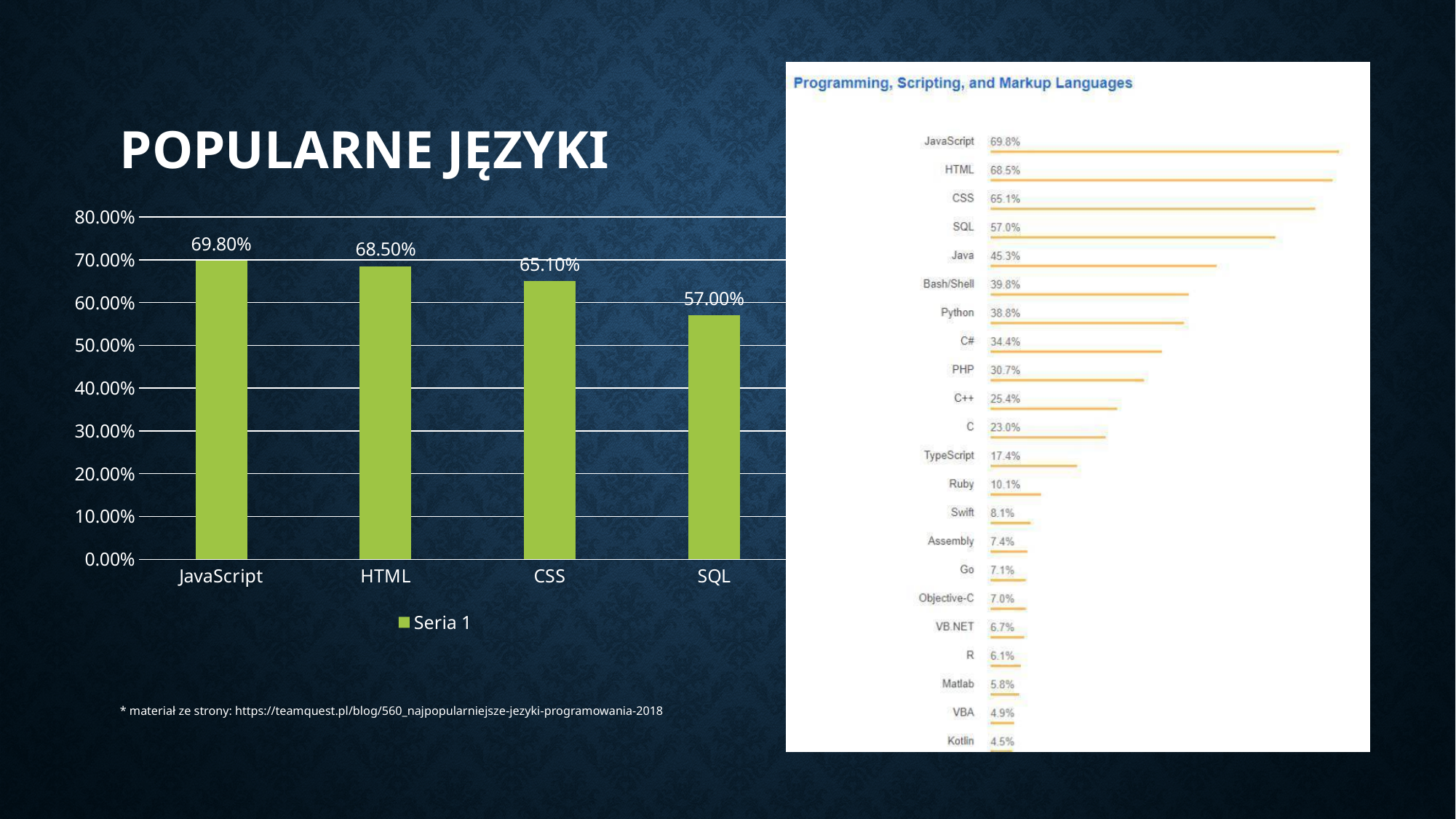
In the left bar chart, how many categories are shown on the x axis? 4 In the left bar chart, which category has the highest value? JavaScript In the chart titled 'Programming, Scripting, and Markup Languages', which is larger, the value for Java or the value for PHP? Java In the left bar chart, how many series does the legend list? 1 In the left bar chart, what is the difference between the values for JavaScript and SQL? 12.80% In the chart titled 'Programming, Scripting, and Markup Languages', which language has the lowest value? Kotlin In the left bar chart, which category has the lowest value? SQL In the left bar chart, what is the value for SQL? 57.00% In the left bar chart, what is the value for JavaScript? 69.80% What kind of chart is the left chart on the slide? Bar chart In the chart titled 'Programming, Scripting, and Markup Languages', what is the value for Python? 38.8% In the left bar chart, do the values rise or fall from JavaScript to SQL along the x axis? Fall